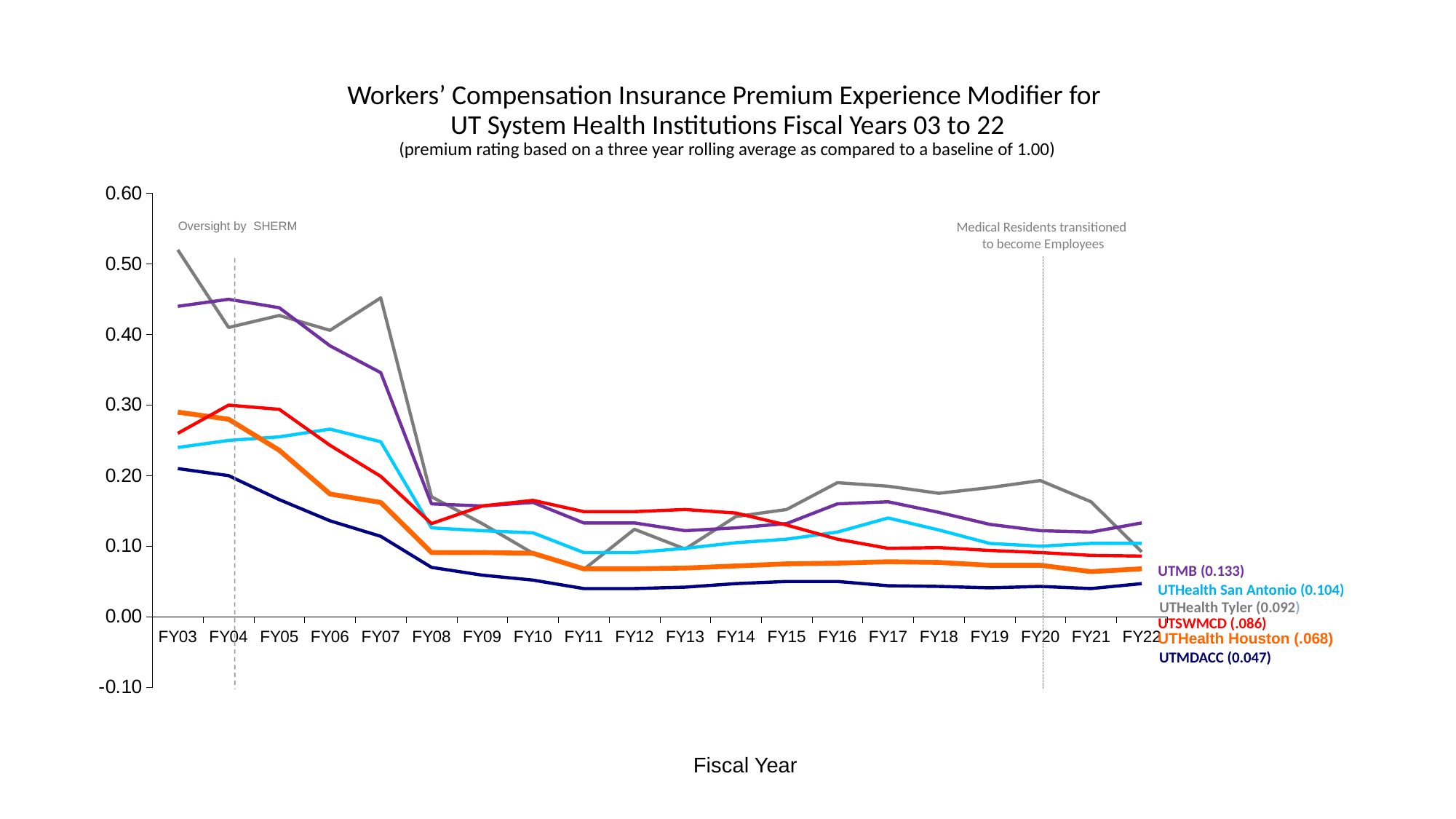
What type of chart is shown on the slide? line chart What is the FY22 experience modifier for UTHealth San Antonio? 0.104 In FY22, which is larger: the value for UTHealth San Antonio or the value for UTSWMCD? UTHealth San Antonio What is the title of the x axis? Fiscal Year What is the FY22 experience modifier for UTMB? 0.133 What is the FY22 experience modifier for UTMDACC? 0.047 Which institution has the highest experience modifier in FY22? UTMB Which institution has the lowest experience modifier in FY22? UTMDACC How many institutions (series) are plotted on the chart? 6 Is the value for UTMB in FY03 greater or less than 0.40? greater What is the difference between the FY22 values for UTMB (0.133) and UTMDACC (0.047)? 0.086 How many fiscal years are shown along the x axis? 20